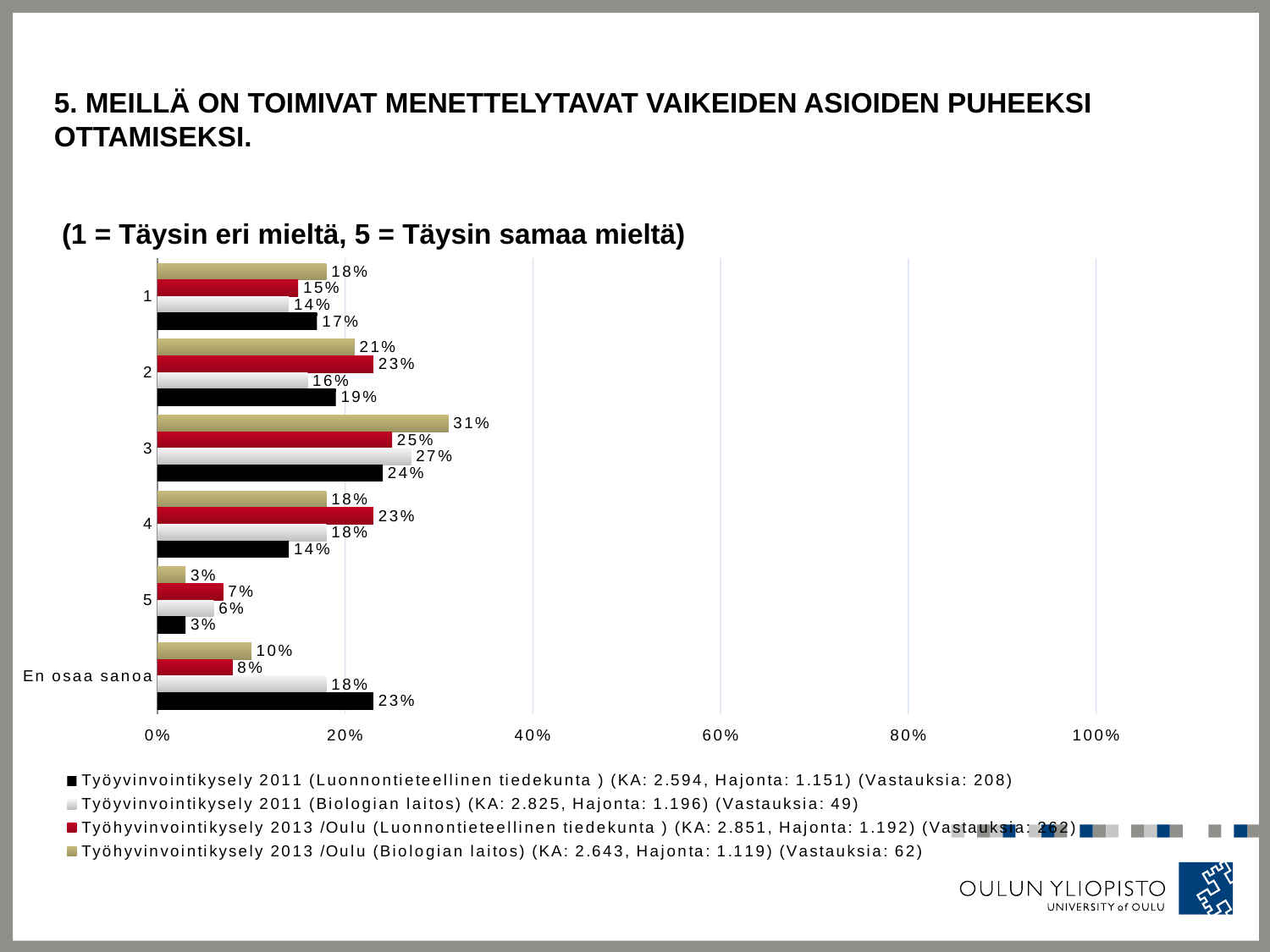
Which category has the highest value in the Työhyvinvointikysely 2013 /Oulu (Biologian laitos) series? 3 For category 5, which is larger: the Työhyvinvointikysely 2013 /Oulu (Luonnontieteellinen tiedekunta) value or the Työyvinvointikysely 2011 (Biologian laitos) value? Työhyvinvointikysely 2013 /Oulu (Luonnontieteellinen tiedekunta) What kind of chart is shown on the slide? Bar chart Which category has the lowest value in the Työhyvinvointikysely 2013 /Oulu (Luonnontieteellinen tiedekunta) series? 5 What is the value for category 3 in the Työhyvinvointikysely 2013 /Oulu (Biologian laitos) series? 31% What is the value for category 4 in the Työhyvinvointikysely 2013 /Oulu (Luonnontieteellinen tiedekunta) series? 23% How many categories are shown on the vertical axis of the chart? 6 What is the difference between the Työhyvinvointikysely 2013 /Oulu (Biologian laitos) value and the Työyvinvointikysely 2011 (Luonnontieteellinen tiedekunta) value for category 3? 7% Is the value for category 3 in the Työhyvinvointikysely 2013 /Oulu (Biologian laitos) series greater or less than 20%? greater What is the value for category 2 in the Työyvinvointikysely 2011 (Biologian laitos) series? 16% What is the value for "En osaa sanoa" in the Työyvinvointikysely 2011 (Luonnontieteellinen tiedekunta) series? 23% How many series does the legend list? 4